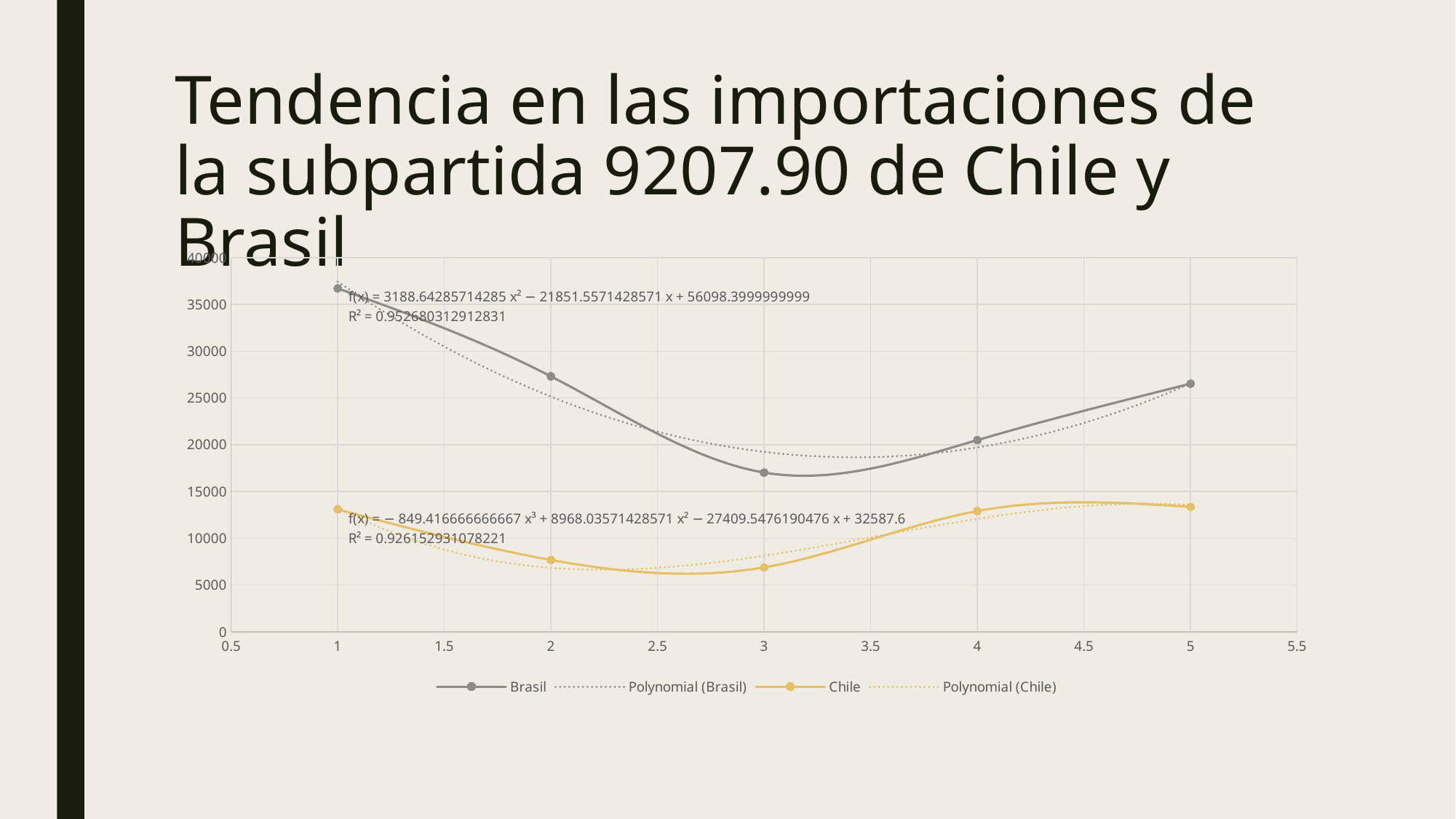
At x = 1, which series has the larger value, Brasil or Chile? Brasil Is the value for Brasil at x = 3 greater or less than 20000? less Is the value for Chile at x = 2 greater or less than 10000? less How many entries does the chart legend list? 4 Is the value for Brasil at x = 1 greater or less than 35000? greater At which x value does the Brasil series reach its lowest value? 3 What R² value is shown for the Brasil polynomial trendline? 0.952680312912831 At which x value does the Brasil series reach its highest value? 1 How many data points are plotted for the Brasil series? 5 What kind of chart is shown on the slide? line chart Does the Brasil series rise or fall between x = 1 and x = 3? fall